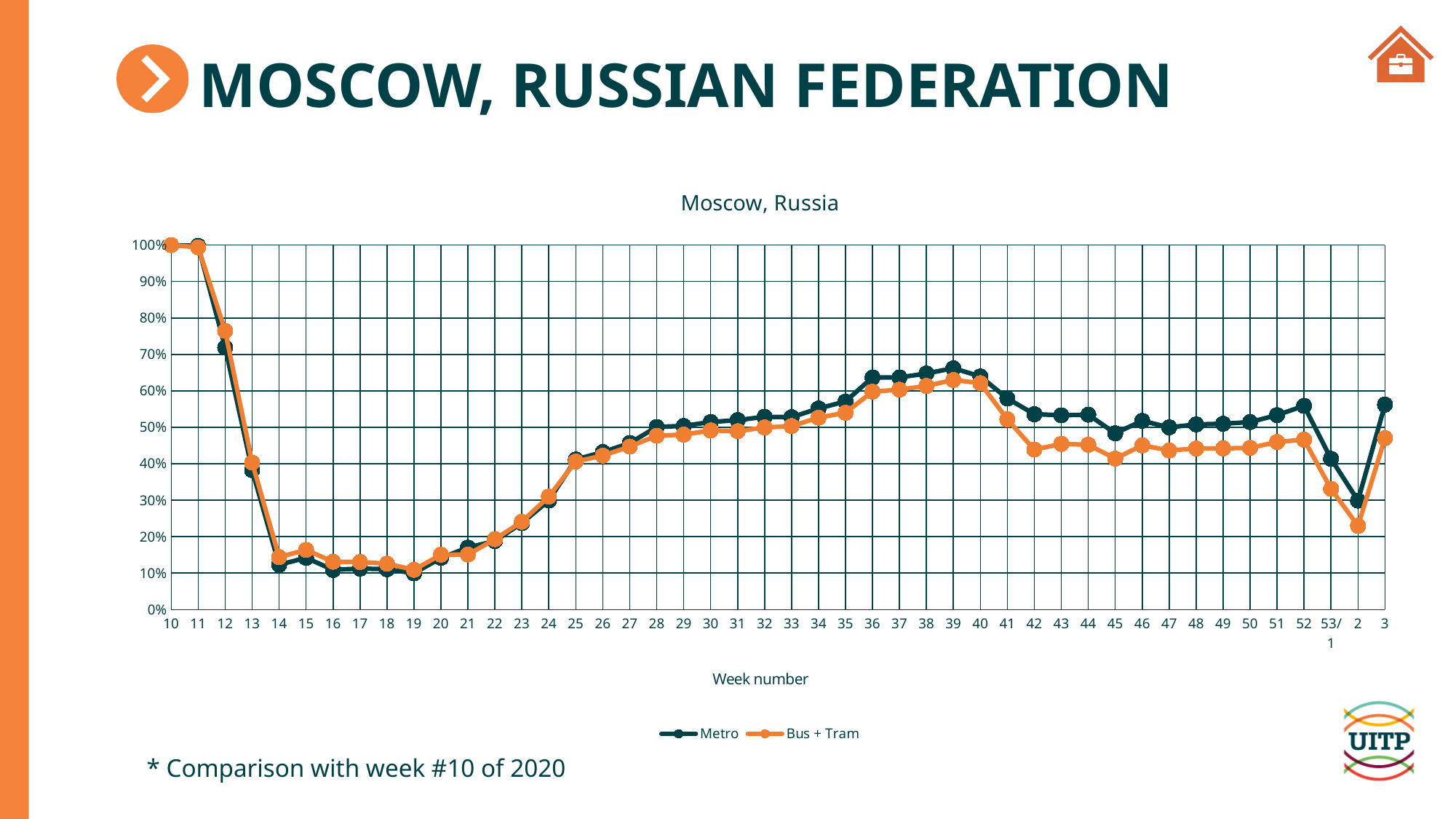
At week 42, which series has the larger value, Metro or Bus + Tram? Metro Is the value for Metro at week 39 greater or less than 60%? greater How many series does the legend list? 2 What type of chart is shown on the slide? line chart Is the value for Metro at week 12 greater or less than 80%? less Is the value for Bus + Tram at week 2 greater or less than 30%? less What is the value for Metro at week 10? 100% What is the title of the chart? Moscow, Russia What is the label of the x axis? Week number At week 15, which series has the larger value, Metro or Bus + Tram? Bus + Tram Do the Metro values rise or fall from week 19 to week 39? rise